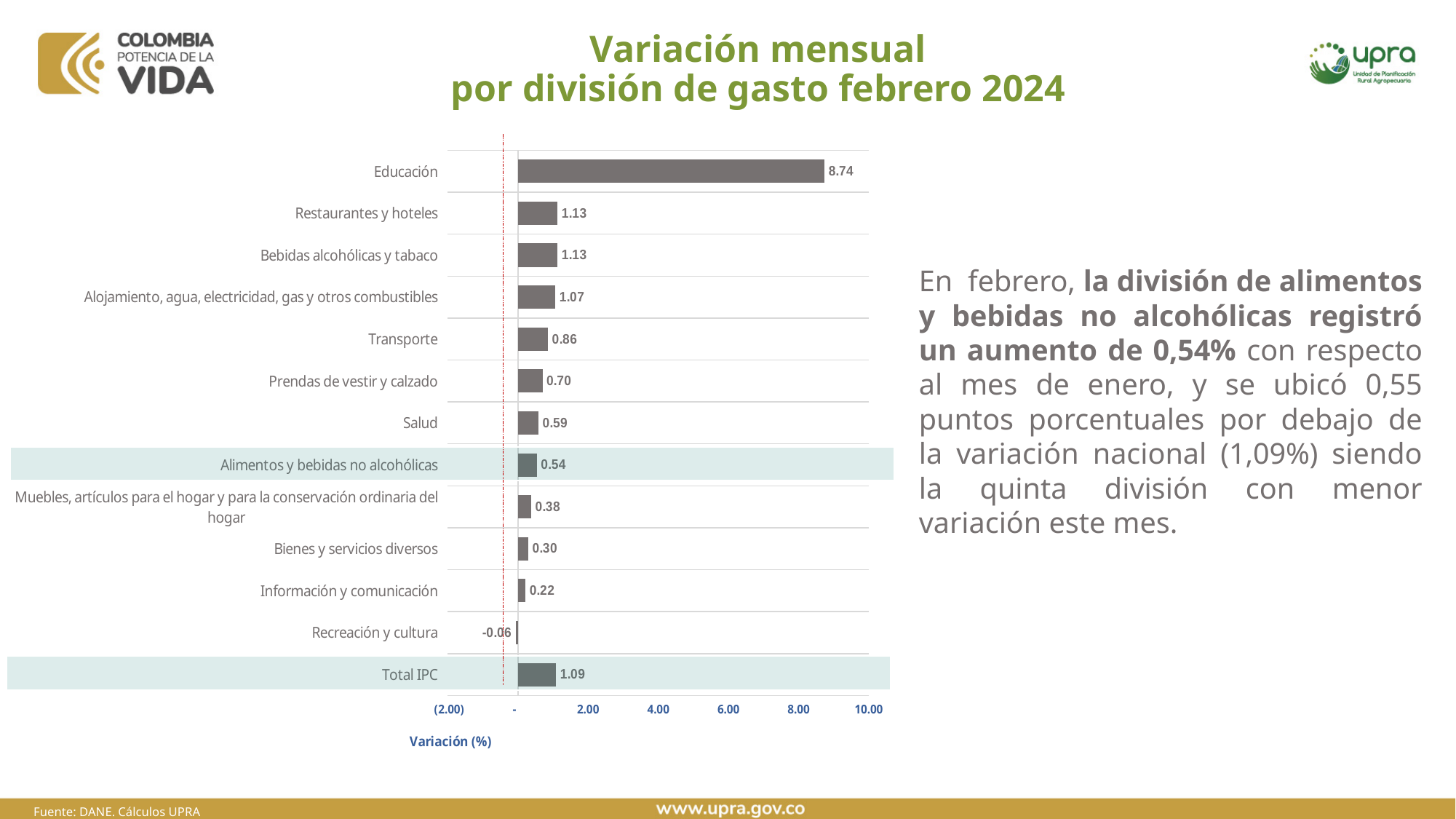
What is the value for Recreación y cultura? -0.06 What is the difference between the values for Total IPC and Alimentos y bebidas no alcohólicas? 0.55 Which category has the lowest value? Recreación y cultura Which is larger, the value for Salud or the value for Bienes y servicios diversos? Salud What kind of chart is shown on the slide? Bar chart What is the label of the horizontal axis? Variación (%) What is the value for Educación? 8.74 What is the difference between the values for Educación and Total IPC? 7.65 Which category has the highest value? Educación What is the value for Total IPC? 1.09 How many categories are shown in the chart? 13 What is the value for Transporte? 0.86